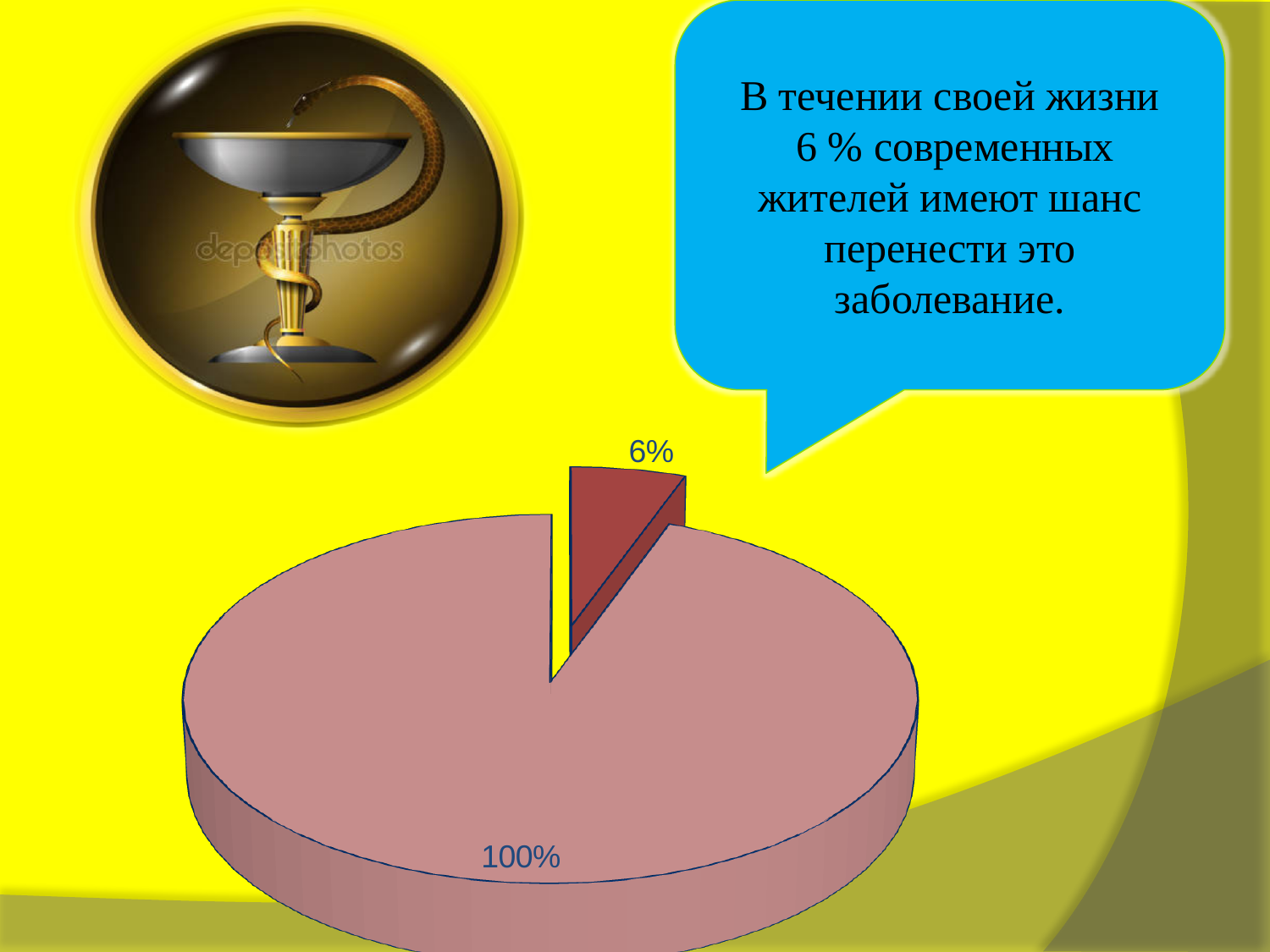
Which slice of the pie chart is the largest? the pink slice labelled 100% Which slice of the pie chart is the smallest? the red slice labelled 6% According to the text on the slide, what percentage of modern residents have a chance of contracting this disease during their lifetime? 6 % Is the slice labelled 6% pulled out (exploded) from the rest of the pie chart? yes Does the pie chart have a legend? no What kind of chart is shown on the slide? pie chart How many slices does the pie chart have? 2 What colour is the slice labelled 6% in the pie chart? red Which slice of the pie chart is larger, the red one or the pink one? the pink one What label is printed on the large pink slice of the pie chart? 100% What label is printed on the small red slice of the pie chart? 6%